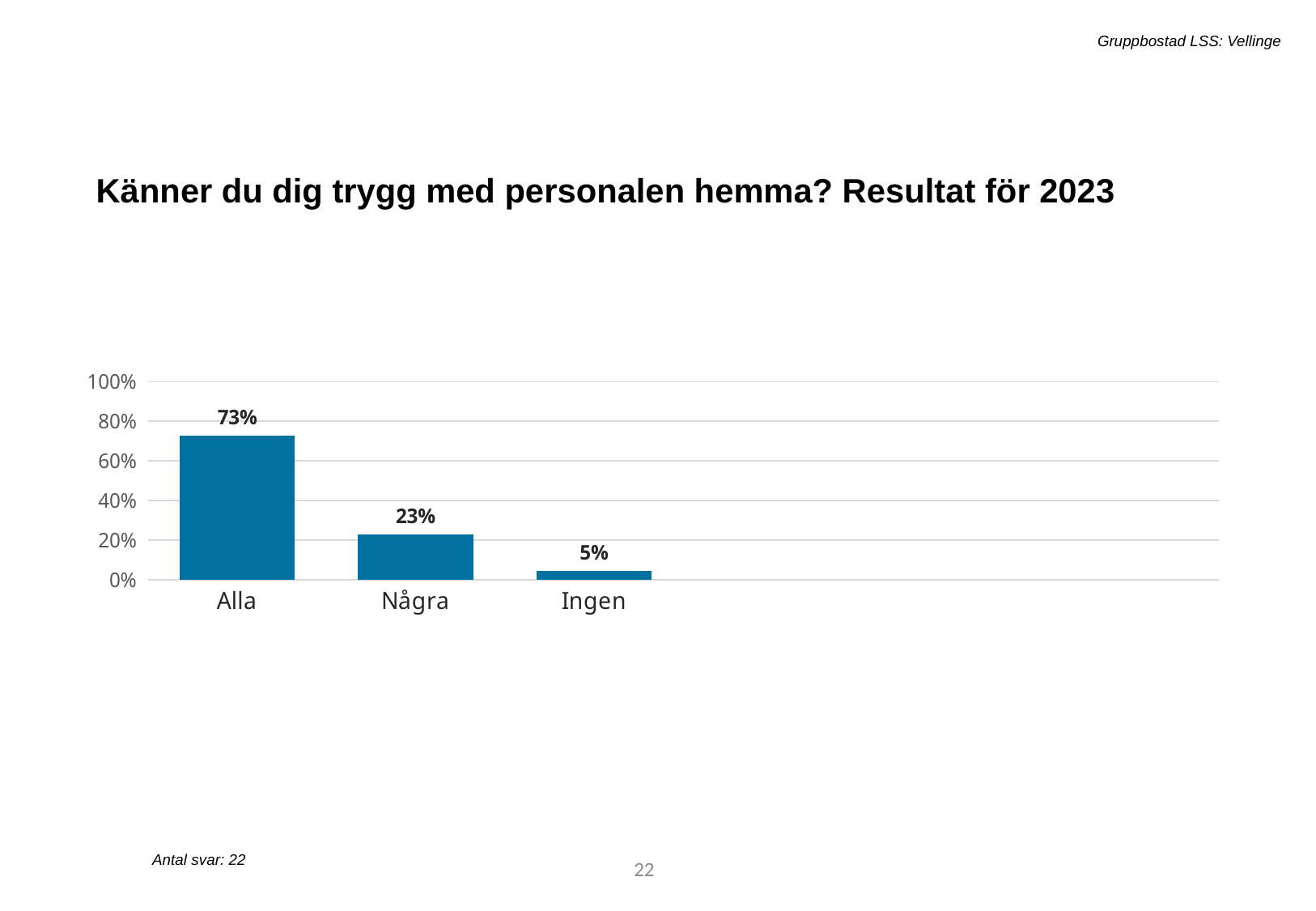
What is the difference between the values for Några and Ingen? 18% What is the value for Ingen? 5% Which category has the highest value? Alla What is the value for Alla? 73% What is the difference between the values for Alla and Några? 50% What is the title of the chart? Känner du dig trygg med personalen hemma? Resultat för 2023 Which category has the lowest value? Ingen Which is larger, the value for Några or the value for Ingen? Några What kind of chart is shown on the slide? bar chart Is the value for Alla greater or less than 60%? greater How many categories are shown on the x axis? 3 What is the value for Några? 23%